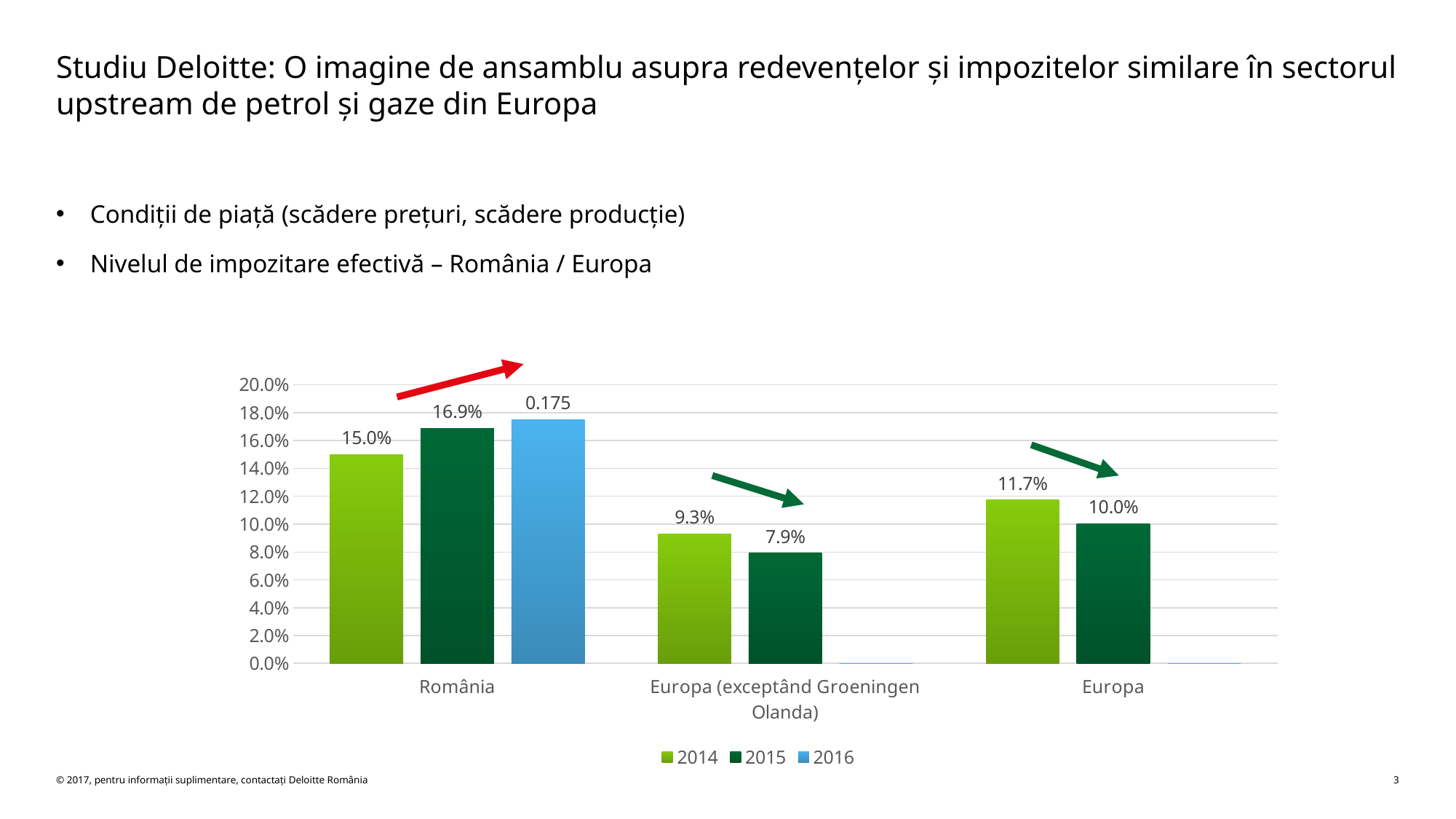
What is the 2015 value for Europa (exceptând Groeningen Olanda)? 7.9% Which is larger: the 2014 value for Europa or the 2015 value for Europa? 2014 value for Europa What is the 2014 value for Europa? 11.7% What data label is shown on the 2016 bar for România? 0.175 How many series does the legend list? 3 Which category has the lowest 2015 value? Europa (exceptând Groeningen Olanda) What is the value for România in 2014? 15.0% Which category has the highest 2014 value? România Which colour represents the 2016 series in the legend? Blue What kind of chart is shown on the slide? Bar chart What is the value for România in 2015? 16.9% By how many percentage points did România's value increase from 2014 to 2015? 1.9 percentage points